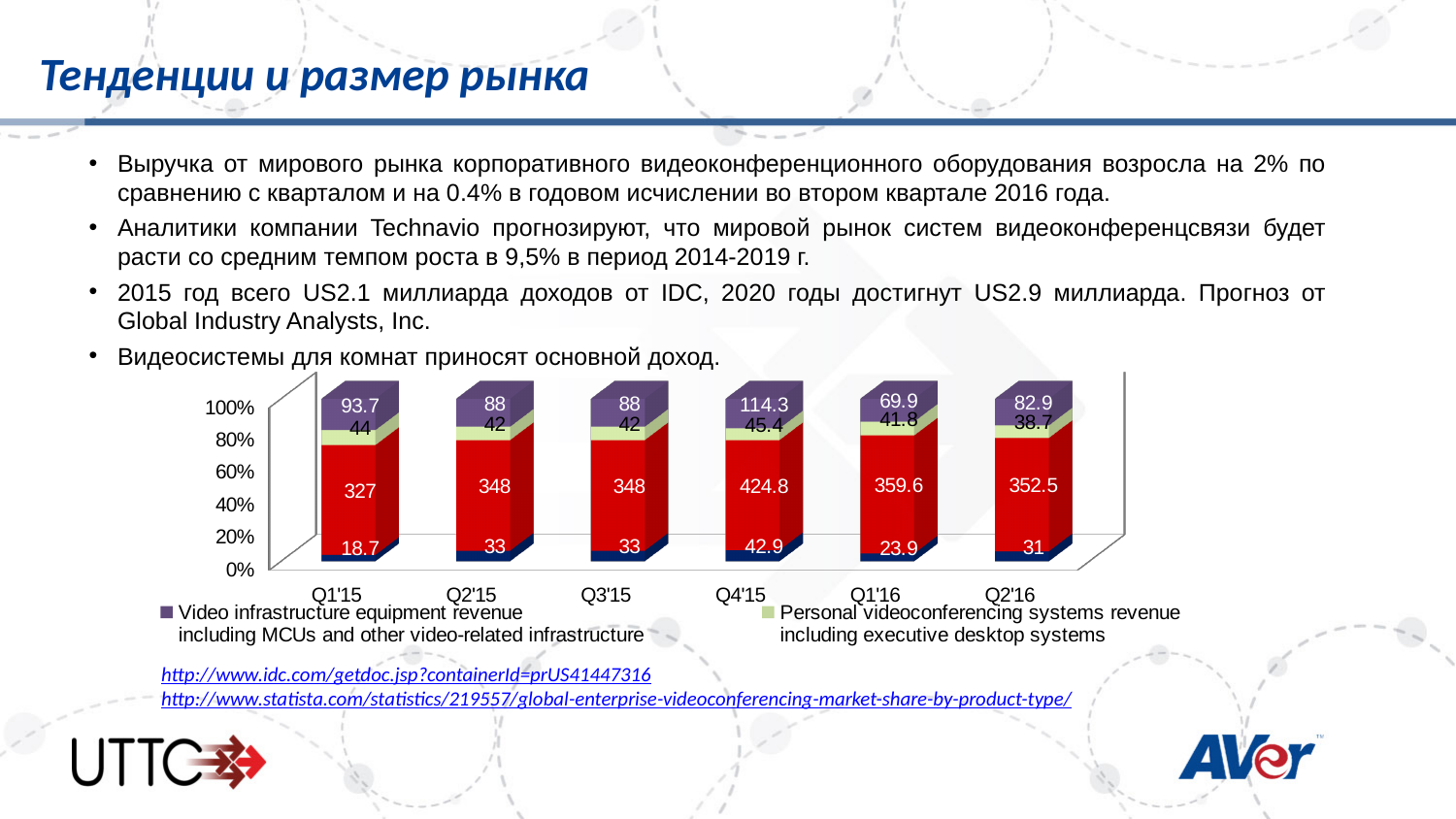
Which quarter has the larger Personal videoconferencing systems revenue value, Q1'15 or Q2'15? Q1'15 What colour represents Personal videoconferencing systems revenue in the legend? Light green What is the value of the Personal videoconferencing systems revenue segment for Q1'16? 41.8 What is the value of the large red segment in the Q4'15 bar? 424.8 What is the total of all segments in the Q2'15 bar? 511 What kind of chart is shown on the slide? Stacked bar chart In which quarter is the Personal videoconferencing systems revenue segment lowest? Q2'16 What is the difference between the Video infrastructure equipment revenue values for Q4'15 and Q1'16? 44.4 What is the value of the Video infrastructure equipment revenue segment for Q4'15? 114.3 How many quarters are shown on the x axis of the chart? 6 In which quarter is the Video infrastructure equipment revenue segment lowest? Q1'16 In which quarter is the Video infrastructure equipment revenue segment highest? Q4'15